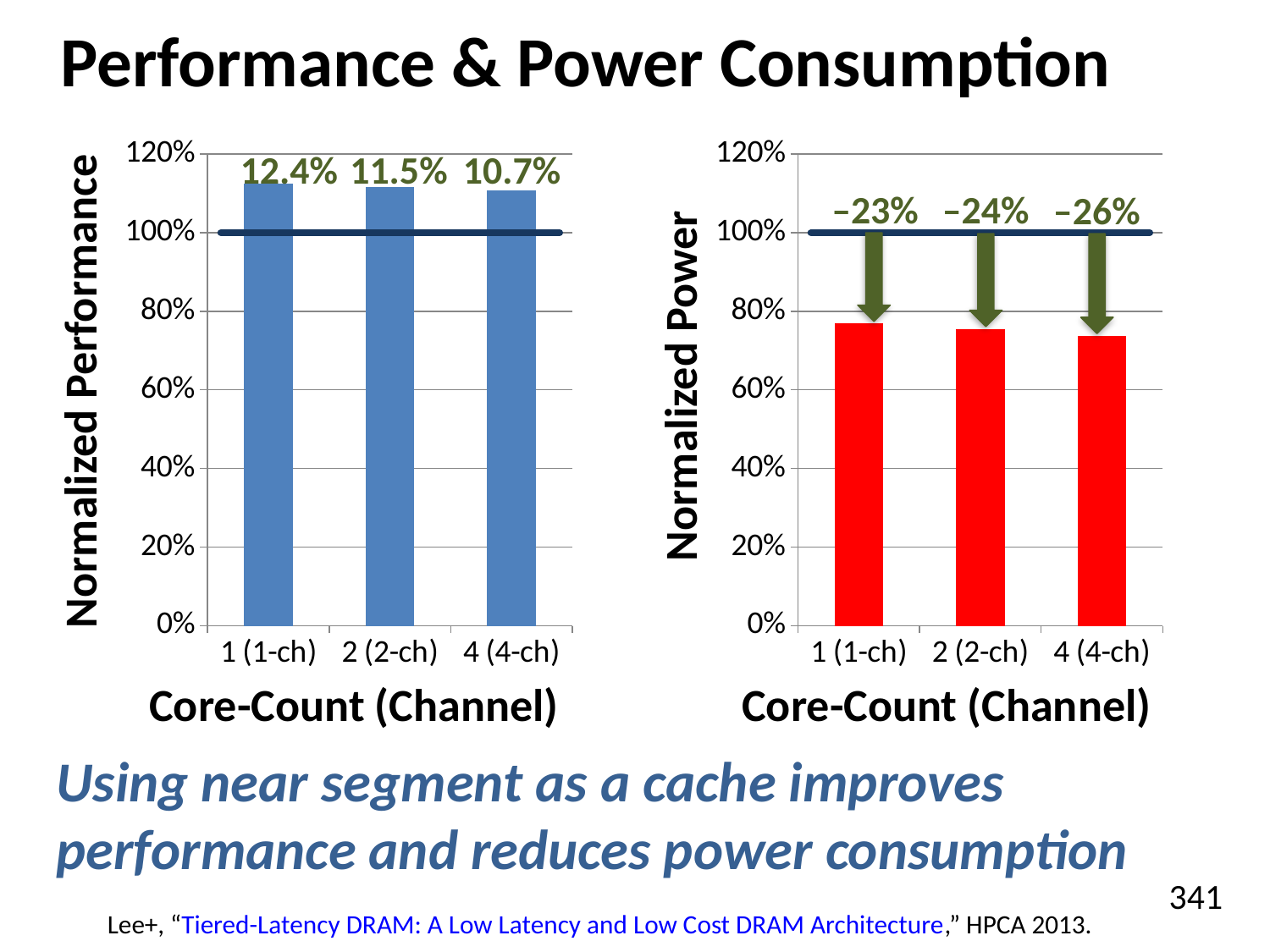
In the Normalized Performance chart on the left, how many categories are shown on the x axis? 3 In the Normalized Power chart on the right, what power reduction is printed above the bar for 4 (4-ch)? –26% In the Normalized Performance chart on the left, is the normalized performance for 2 (2-ch) greater or less than 100%? greater In the Normalized Performance chart on the left, do the printed performance improvements rise or fall as the core count increases from 1 to 4? fall In the Normalized Performance chart on the left, which core-count configuration has the largest printed performance improvement? 1 (1-ch) In the Normalized Performance chart on the left, what performance improvement is printed above the bar for 1 (1-ch)? 12.4% What kind of chart is the Normalized Performance chart on the left? bar chart In the Normalized Power chart on the right, which core-count configuration has the lowest normalized power bar? 4 (4-ch) In the Normalized Power chart on the right, what power reduction is printed above the bar for 2 (2-ch)? –24% In the Normalized Performance chart on the left, what is the difference between the printed improvements for 1 (1-ch) and 4 (4-ch)? 1.7% In the Normalized Performance chart on the left, what performance improvement is printed above the bar for 4 (4-ch)? 10.7% In the Normalized Power chart on the right, is the normalized power for 1 (1-ch) greater or less than 80%? less